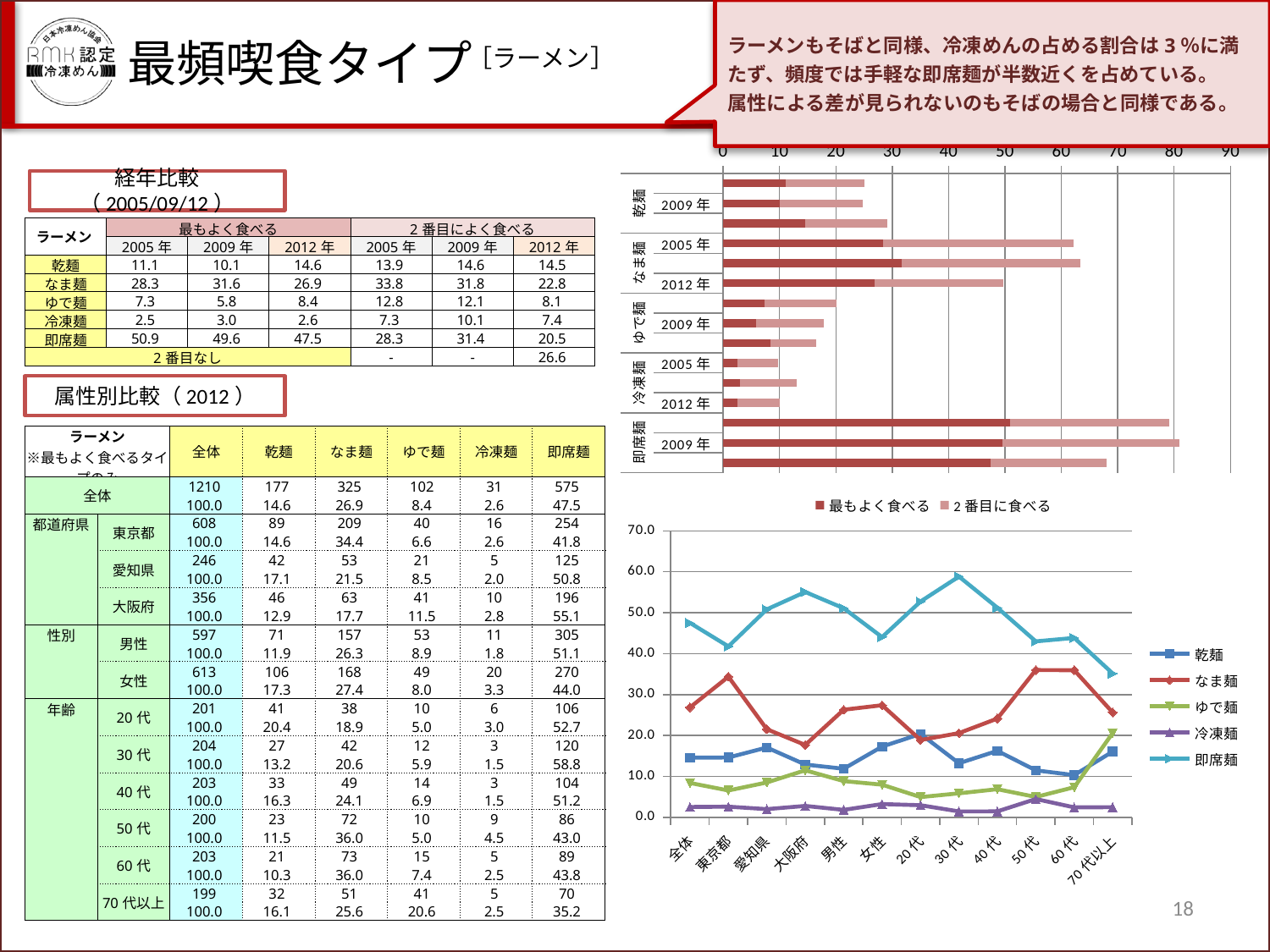
In the bottom-right line chart, which series has the highest values across the categories? 即席麺 In the top-right bar chart, how many series does the legend list? 2 In the bottom-right line chart, how many series does the legend list? 5 In the top-right bar chart, is the 最もよく食べる value for 即席麺 in 2009年 greater or less than 40? greater What kind of chart is the top-right chart on the slide? bar chart In the bottom-right line chart, at 全体, which is larger: 乾麺 or ゆで麺? 乾麺 In the bottom-right line chart, is the value for なま麺 at 大阪府 greater or less than 20.0? less In the bottom-right line chart, which series has the lowest values across the categories? 冷凍麺 What kind of chart is the bottom-right chart on the slide? line chart In the bottom-right line chart, how many categories are shown along the x axis? 12 In the bottom-right line chart, does the 即席麺 line rise or fall from 30代 to 70代以上? fall In the bottom-right line chart, is the value for 即席麺 at 30代 greater or less than 50.0? greater